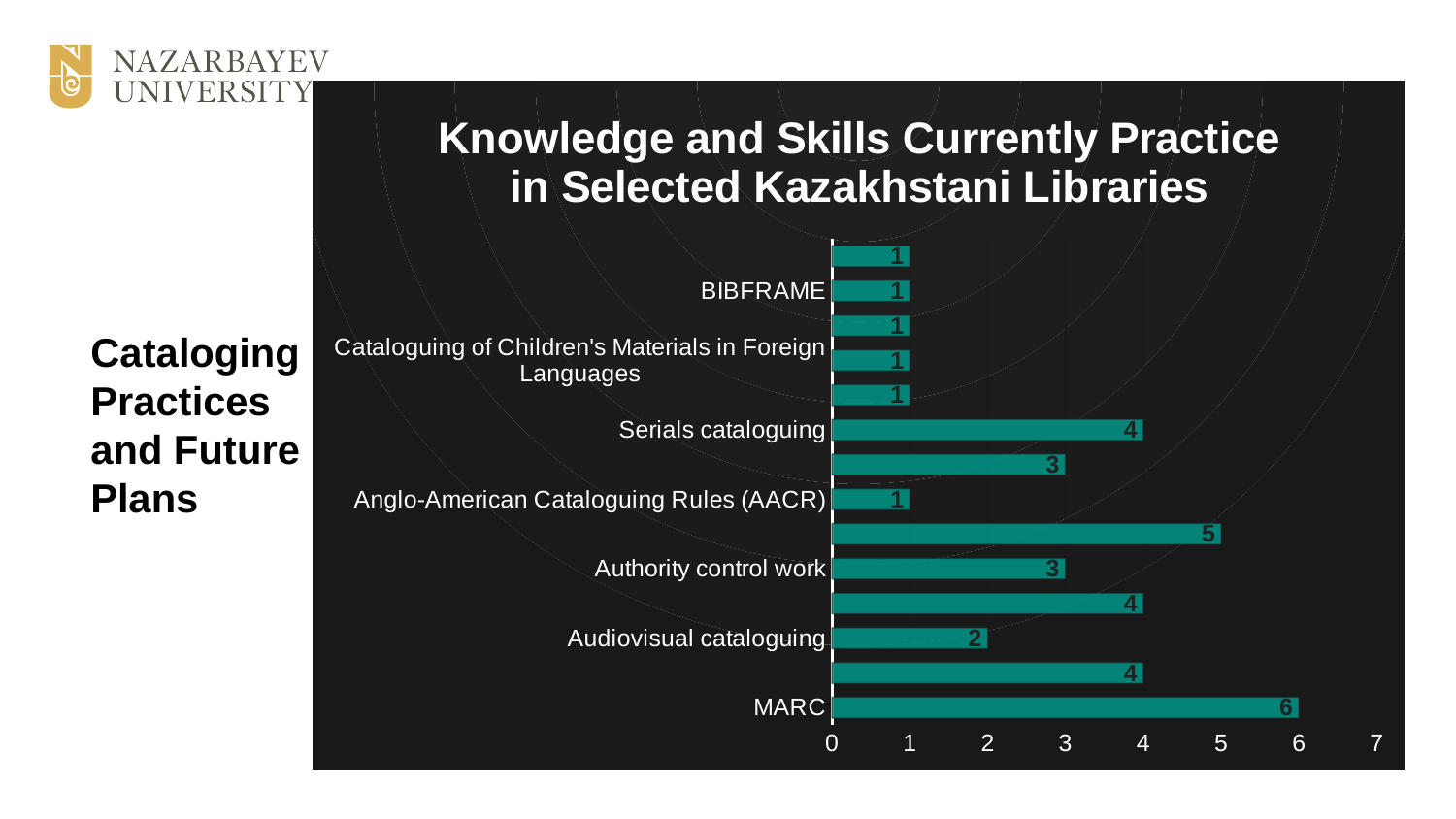
What is the value for BIBFRAME? 1 What is the value for MARC? 6 What is the value for Audiovisual cataloguing? 2 What is the value for Anglo-American Cataloguing Rules (AACR)? 1 How many bars are plotted in the chart? 14 Which is larger, the value for Serials cataloguing or the value for Authority control work? Serials cataloguing What is the value for Authority control work? 3 Which labeled category has the highest value? MARC What is the title of the chart? Knowledge and Skills Currently Practice in Selected Kazakhstani Libraries What is the value for Serials cataloguing? 4 What type of chart is shown on the slide? bar chart What is the difference between the values for MARC and Audiovisual cataloguing? 4